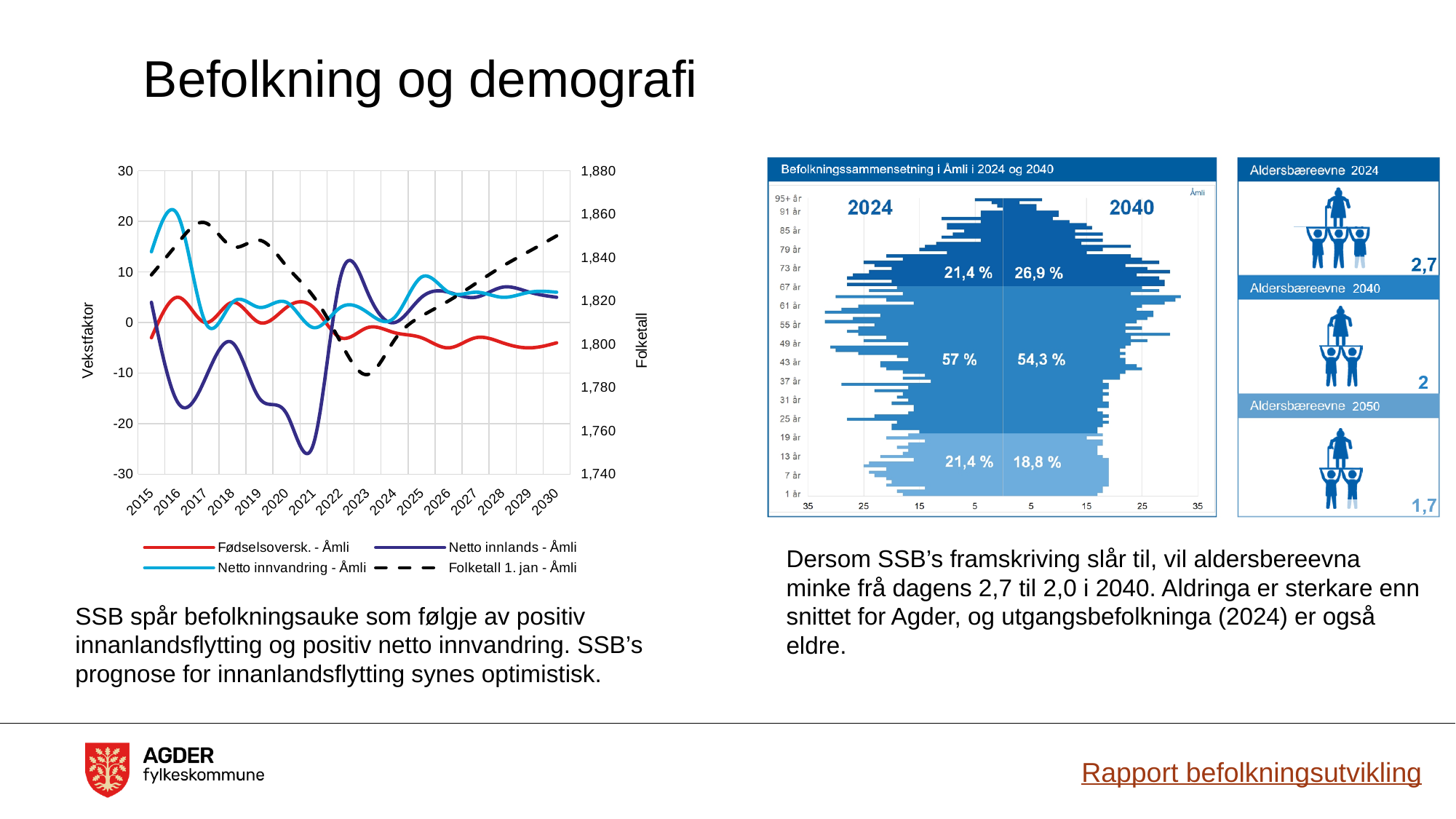
In the left-hand line chart, is the value for Netto innlands - Åmli in 2021 greater or less than -20? less In the left-hand line chart, in which year does Netto innlands - Åmli reach its lowest value? 2021 In the chart 'Befolkningssammensetning i Åmli i 2024 og 2040', what share of the population is aged 67 and over in 2024? 21,4 % What kind of chart is the left-hand chart with the Vekstfaktor axis? line chart In the chart 'Befolkningssammensetning i Åmli i 2024 og 2040', what share of the population is in the middle age group in 2040? 54,3 % How many years are shown on the x axis of the left-hand line chart? 16 In the left-hand line chart, does the Folketall 1. jan - Åmli line rise or fall from 2024 to 2030? rise How many series does the legend of the left-hand line chart list? 4 In the chart 'Befolkningssammensetning i Åmli i 2024 og 2040', what share of the population is in the youngest age group in 2040? 18,8 % In the chart 'Befolkningssammensetning i Åmli i 2024 og 2040', by how many percentage points does the 67+ share in 2040 exceed the 67+ share in 2024? 5,5 In the Aldersbæreevne panels on the right, what is the value shown for 2050? 1,7 In the left-hand line chart, is the value for Netto innvandring - Åmli in 2016 greater or less than 20? greater